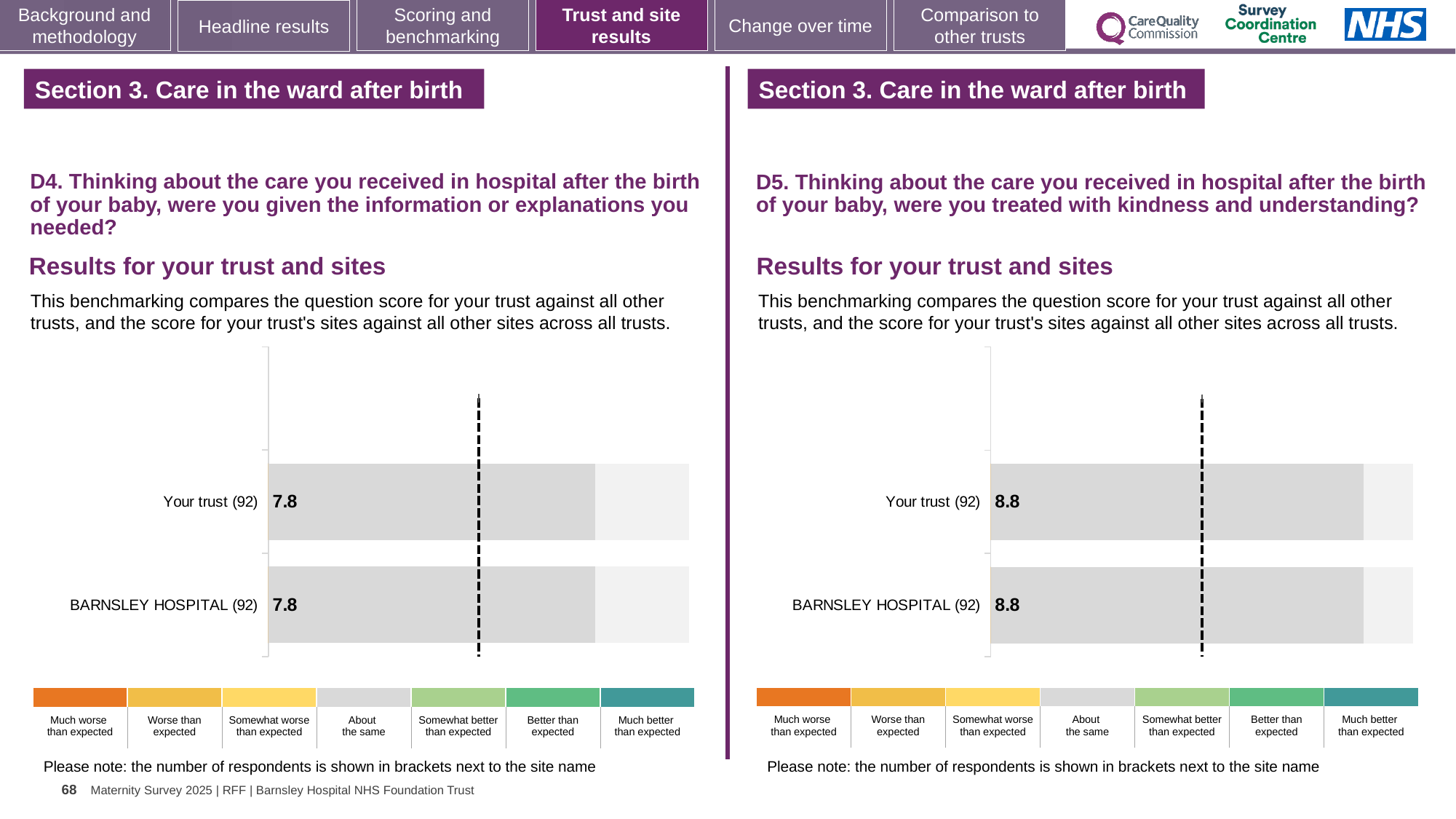
On the left chart (D4), how many respondents are shown in brackets for Your trust? 92 On the left chart (D4), what is the score for Your trust? 7.8 What is the difference between the BARNSLEY HOSPITAL score on the right chart (D5) and on the left chart (D4)? 1.0 On the right chart (D5), what is the score for Your trust? 8.8 How many bars are plotted on the left chart (D4)? 2 Which is larger: the Your trust score on the left chart (D4) or the Your trust score on the right chart (D5)? Right chart (D5) What kind of chart is used on the left (D4)? Bar chart On the left chart (D4), what is the score for BARNSLEY HOSPITAL? 7.8 How many bars are plotted on the right chart (D5)? 2 How many benchmark categories does the colour key below the right chart (D5) list? 7 On the right chart (D5), what is the score for BARNSLEY HOSPITAL? 8.8